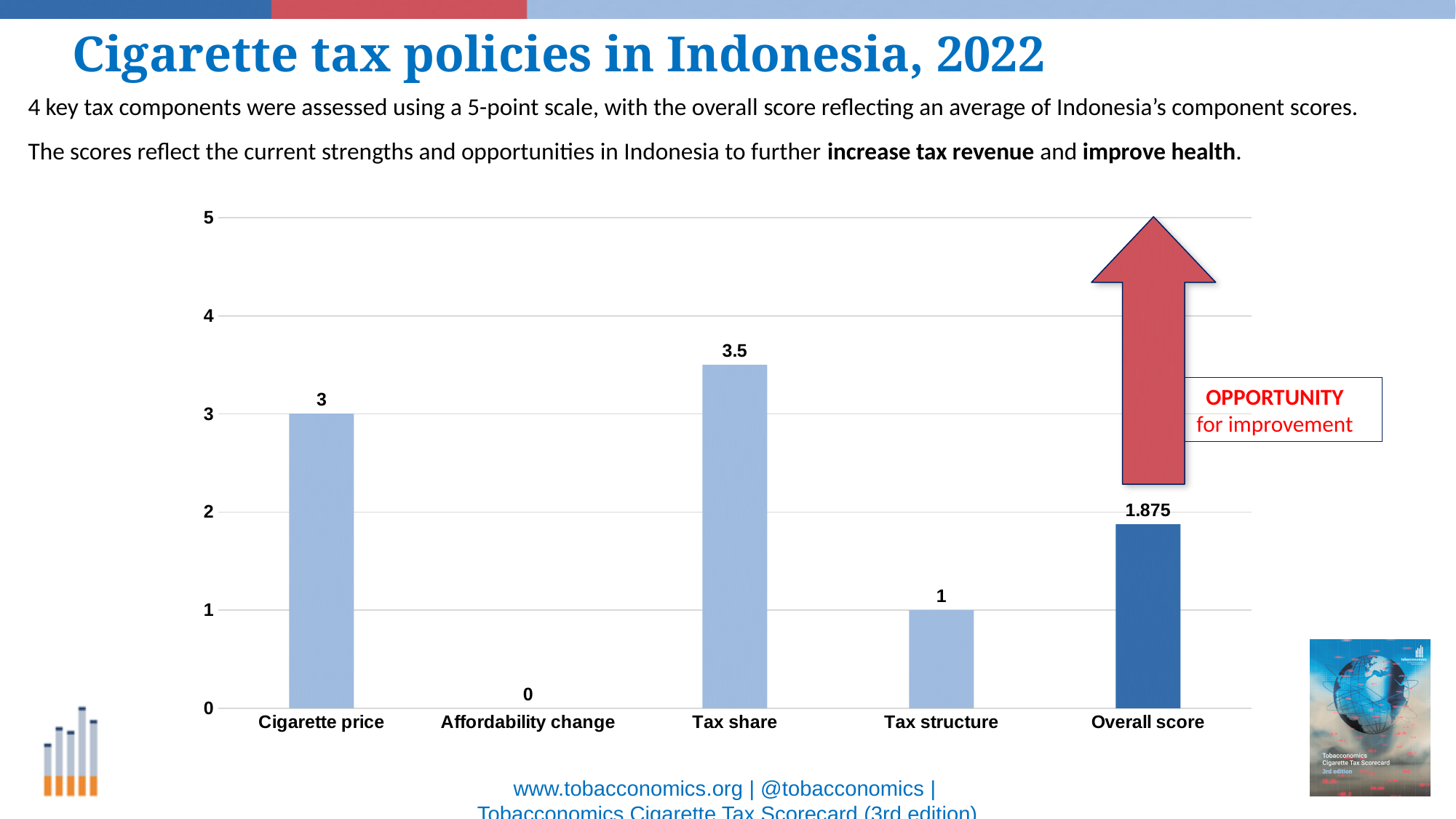
Is the Overall score greater or less than 2? less What is the maximum value shown on the y axis of the chart? 5 What is the score for Tax share? 3.5 What is the difference between the Tax share score and the Tax structure score? 2.5 Which category has the lowest score? Affordability change Which category has the highest score? Tax share What is the Overall score shown on the chart? 1.875 What is the score for Cigarette price? 3 How many categories are shown on the x axis of the chart? 5 What is the score for Affordability change? 0 What kind of chart is shown on the slide? bar chart Which is larger, the score for Cigarette price or the score for Tax structure? Cigarette price